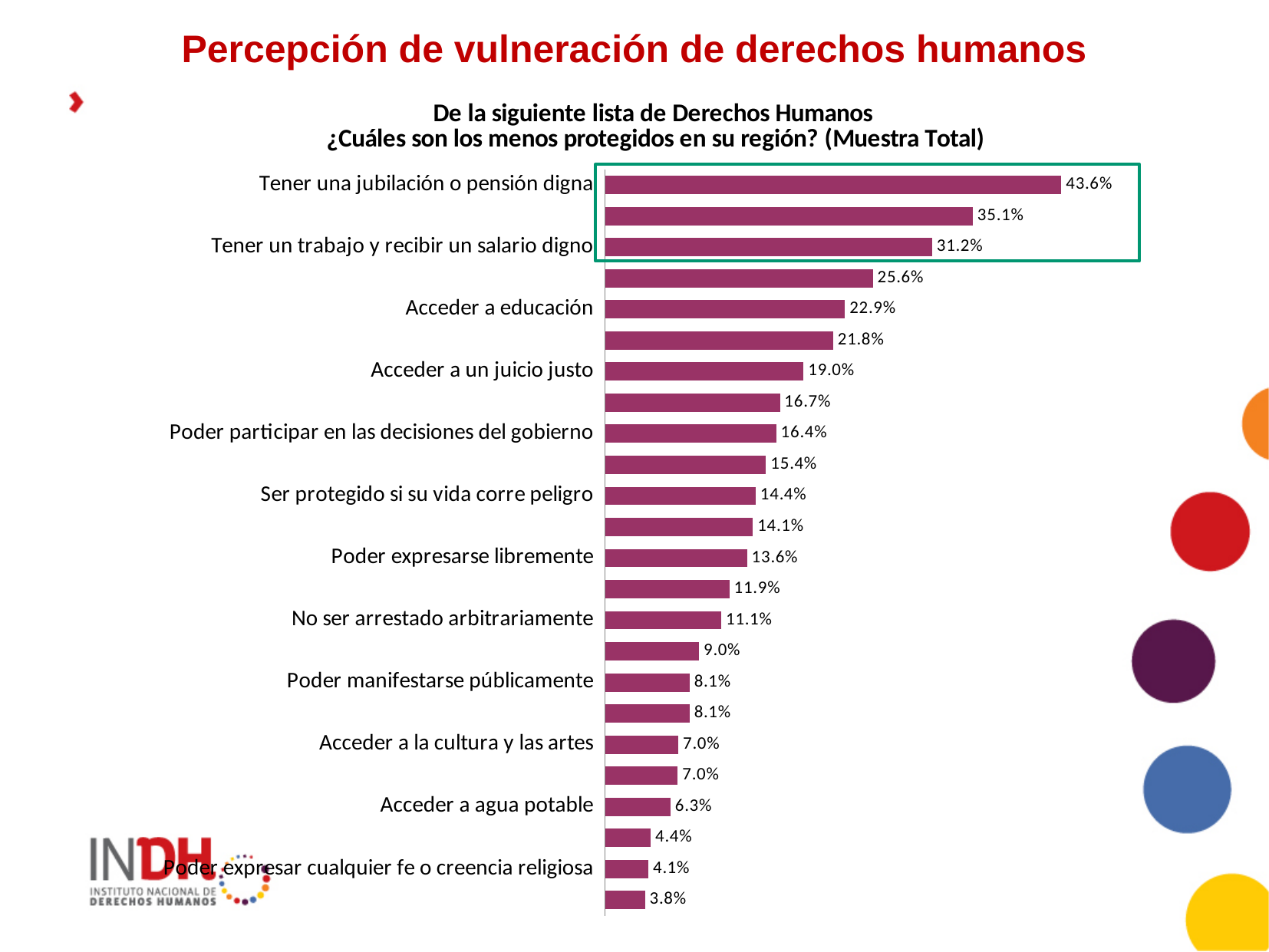
Which is larger, the value for "Acceder a un juicio justo" or the value for "Ser protegido si su vida corre peligro"? Acceder a un juicio justo How many bars are plotted in the chart? 24 What is the title of the chart? De la siguiente lista de Derechos Humanos ¿Cuáles son los menos protegidos en su región? (Muestra Total) What is the value for "Acceder a agua potable"? 6.3% What kind of chart is shown on the slide? bar chart What is the value for "Tener una jubilación o pensión digna"? 43.6% Which category has the highest value in the chart? Tener una jubilación o pensión digna What is the difference between the values for "Tener una jubilación o pensión digna" and "Tener un trabajo y recibir un salario digno"? 12.4% What is the value for "Tener un trabajo y recibir un salario digno"? 31.2% What is the lowest value shown in the chart? 3.8% What is the value for "Acceder a educación"? 22.9% What is the value for "Poder expresarse libremente"? 13.6%